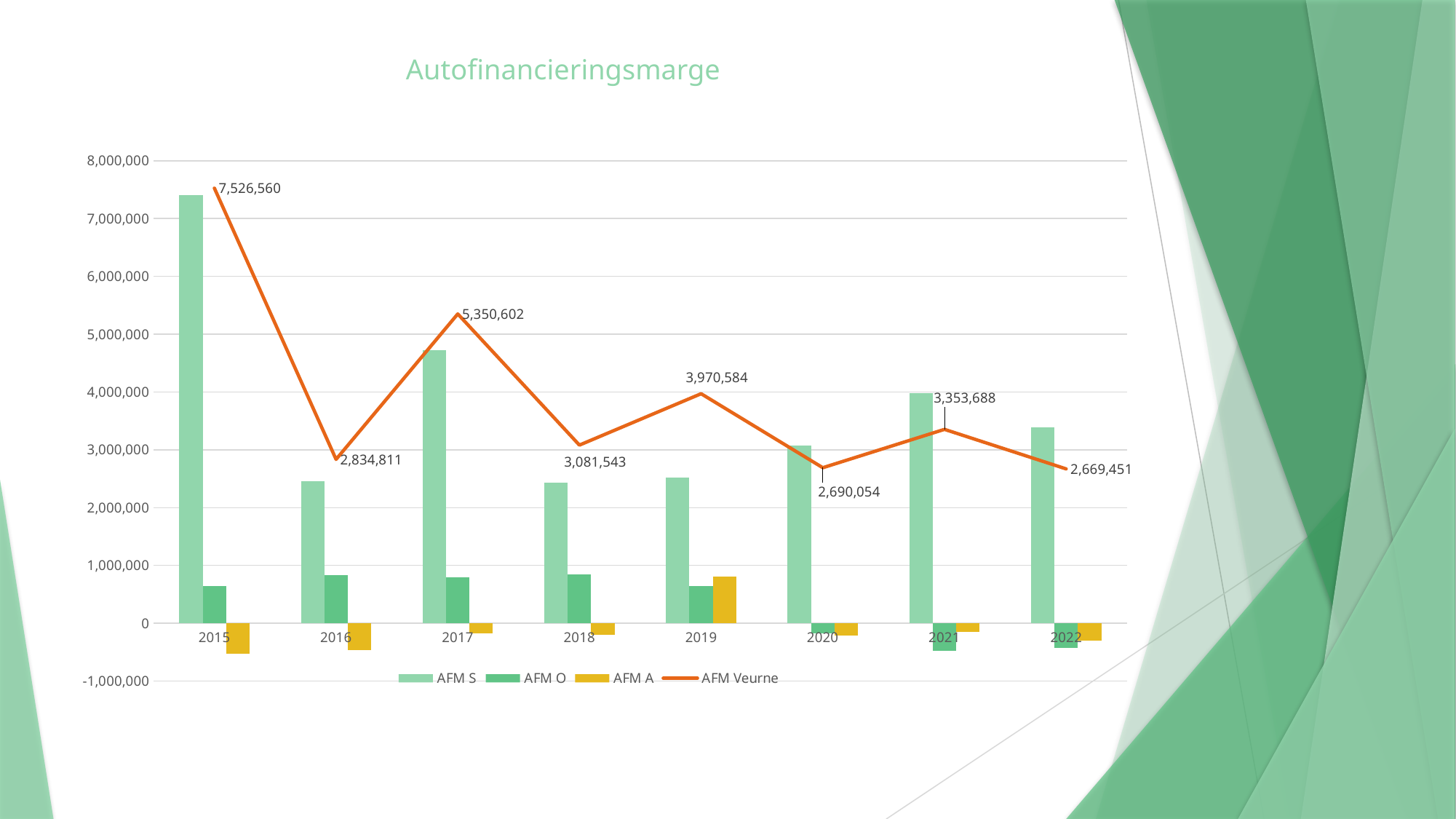
What is the title of the chart? Autofinancieringsmarge How many years are shown on the x axis? 8 In which year is the AFM Veurne value lowest? 2022 What is the AFM Veurne value for 2019? 3,970,584 Which is larger, the AFM Veurne value for 2017 or for 2018? 2017 In which year is the AFM Veurne value highest? 2015 How many series does the legend list? 4 What is the difference between the AFM Veurne values for 2015 and 2016? 4,691,749 Is the AFM S value for 2015 greater or less than 7,000,000? greater Is the AFM O value for 2016 greater or less than 1,000,000? less What is the AFM Veurne value for 2015? 7,526,560 What is the AFM Veurne value for 2022? 2,669,451